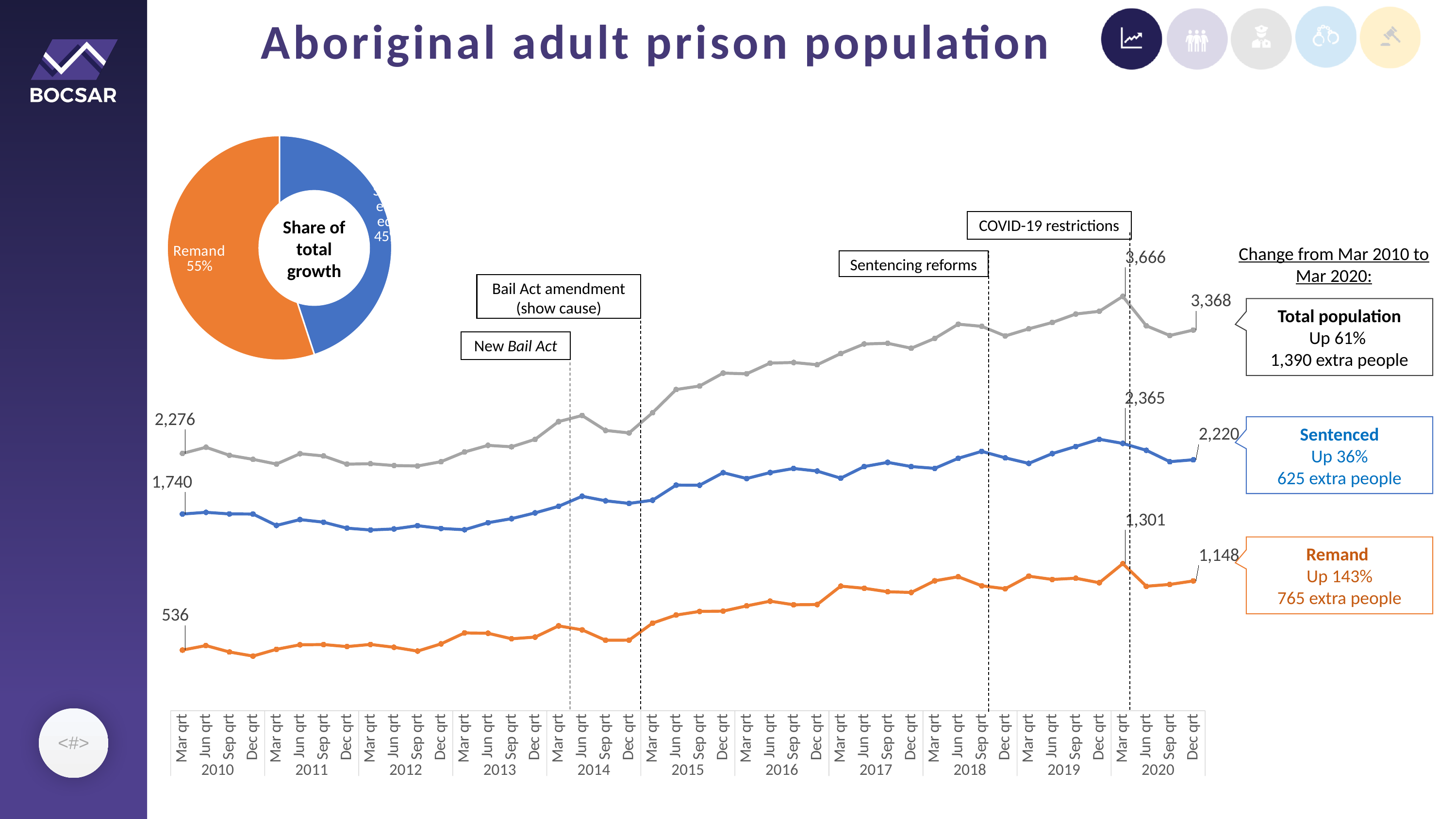
On the line chart, which series is higher in the Dec quarter of 2020, Sentenced or Remand? Sentenced On the line chart, what was the Sentenced value in the Dec quarter of 2020? 2,220 According to the callout on the line chart, by what percentage did the Remand population change from Mar 2010 to Mar 2020? Up 143% On the line chart, what was the total Aboriginal adult prison population in the Mar quarter of 2020? 3,666 On the line chart, what is the difference between the Sentenced and Remand values in the Mar quarter of 2010? 1,204 On the 'Share of total growth' chart, what share does Remand account for? 55% On the line chart, what was the Remand value in the Mar quarter of 2010? 536 On the line chart, what was the Remand value in the Mar quarter of 2020? 1,301 What kind of chart is the 'Share of total growth' chart? pie chart (donut) On the line chart, how many years are shown on the x axis? 11 On the line chart, does the Remand series generally rise or fall from 2010 to 2020? rise On the line chart, what is the difference between the total population in the Mar quarter of 2020 and the Dec quarter of 2020? 298